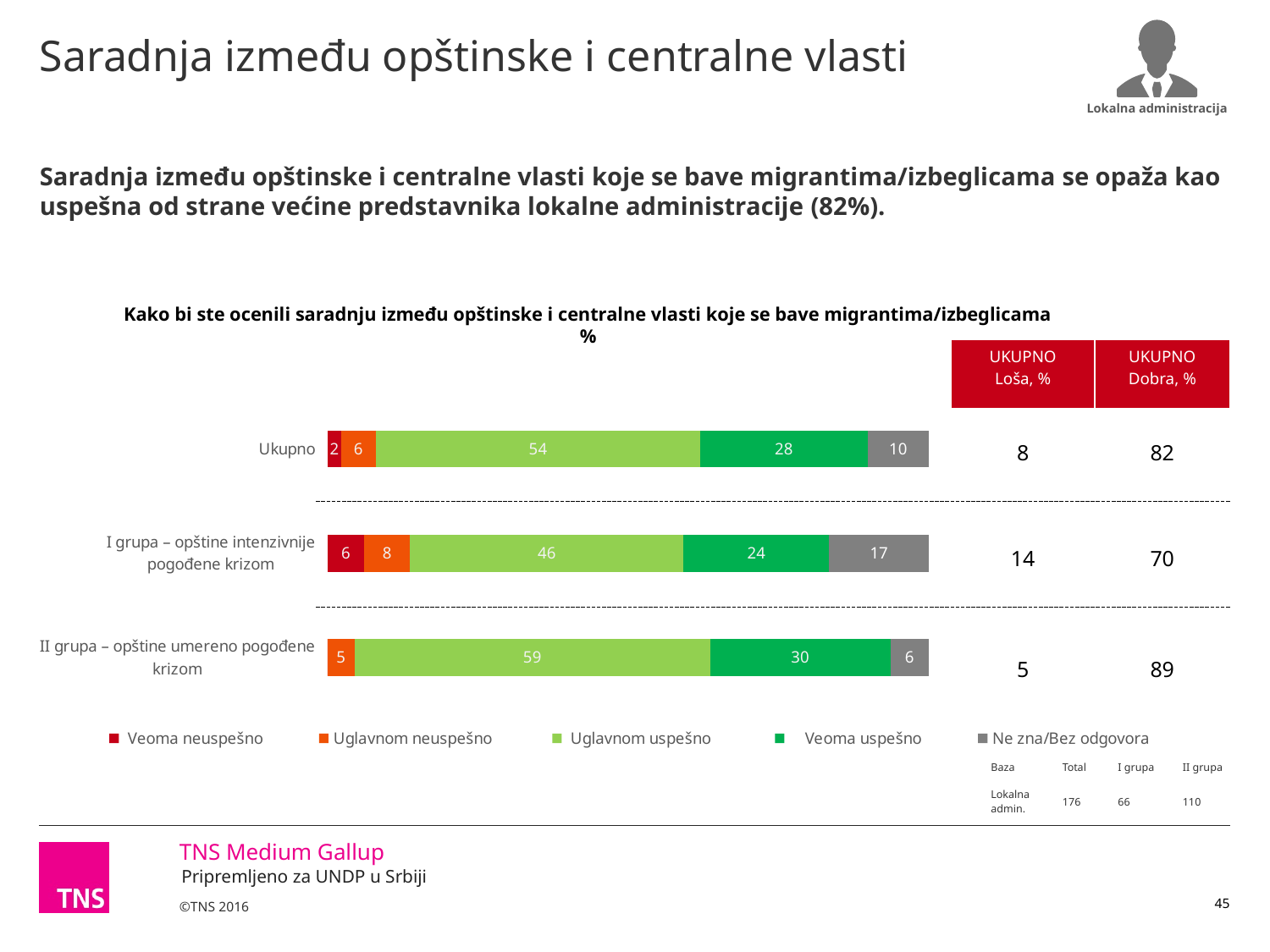
Which is larger: 'Uglavnom neuspešno' for 'I grupa' or for 'II grupa'? I grupa What kind of chart is shown on the slide? Stacked bar chart Which category has the highest value for 'Uglavnom uspešno'? II grupa – opštine umereno pogođene krizom How many series does the chart legend list? 5 Which colour represents 'Veoma neuspešno' in the legend? Dark red What is the value of 'Uglavnom uspešno' for 'Ukupno'? 54 What is the value of 'Ne zna/Bez odgovora' for 'II grupa – opštine umereno pogođene krizom'? 6 How many categories (rows) are plotted in the chart? 3 Which category has the lowest value for 'Veoma uspešno'? I grupa – opštine intenzivnije pogođene krizom What is the difference between the 'Ne zna/Bez odgovora' values for 'I grupa' and 'Ukupno'? 7 What is the 'UKUPNO Dobra, %' value for 'I grupa – opštine intenzivnije pogođene krizom'? 70 What is the value of 'Veoma uspešno' for 'I grupa – opštine intenzivnije pogođene krizom'? 24